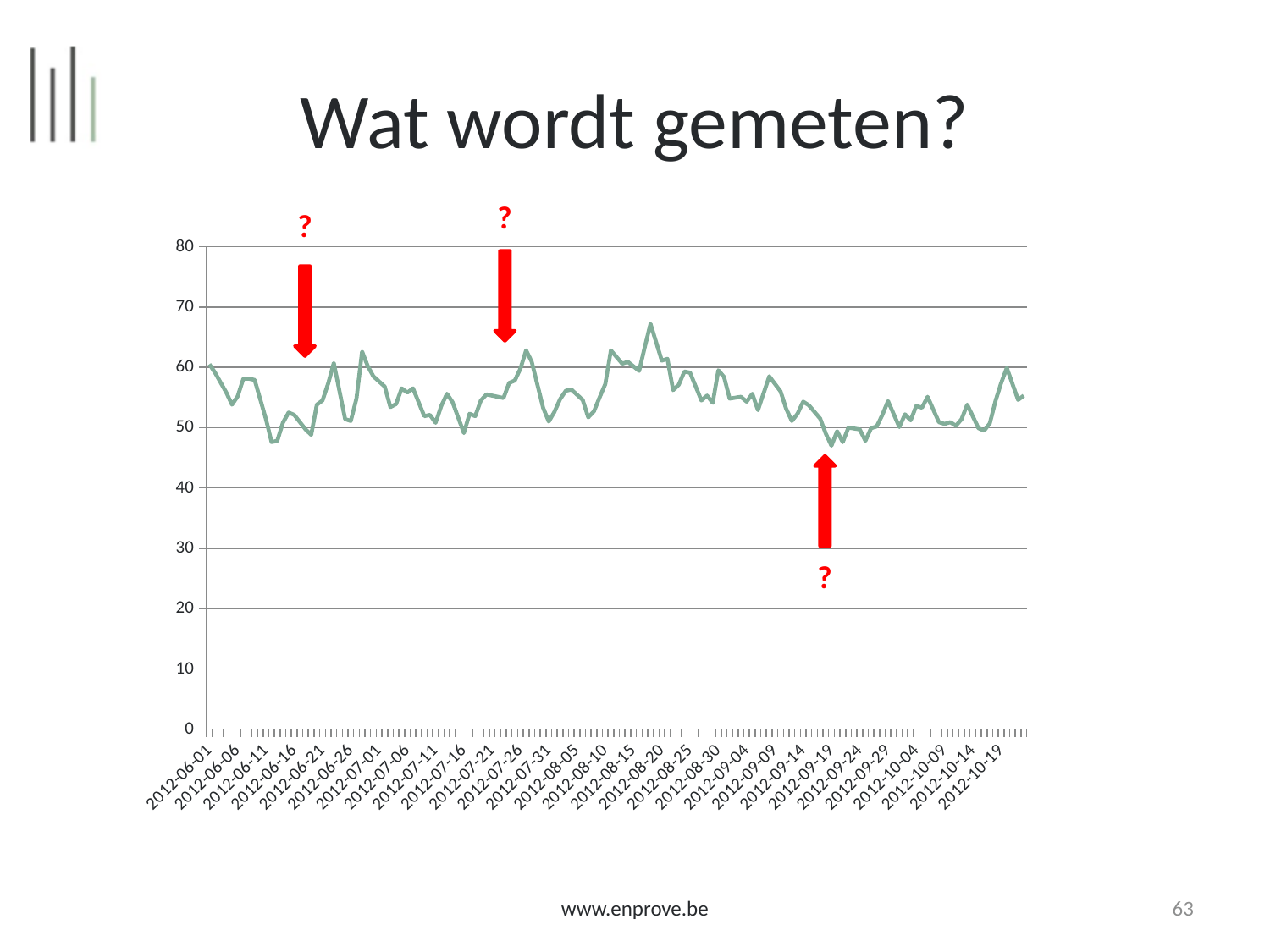
Is the highest point of the line greater or less than 70? less What kind of chart is shown on the slide? line chart What is the highest value shown on the vertical axis? 80 What is the first date label on the horizontal axis? 2012-06-01 Comparing the start of the series (2012-06-01) with the end (after 2012-10-19), does the line end higher or lower than it starts? lower Does the line ever rise above 80? no Is the value around 2012-09-19 greater or less than 60? less